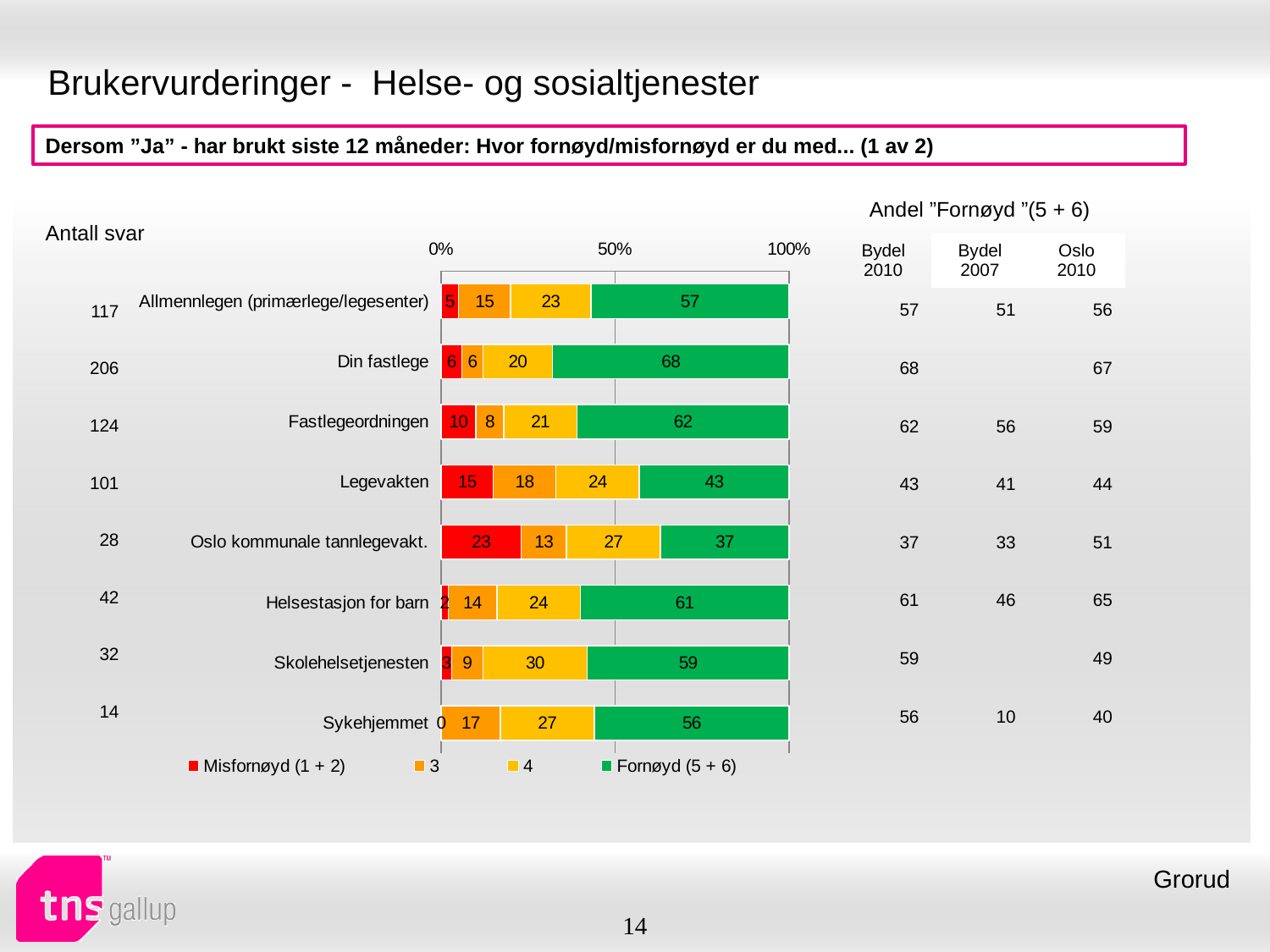
What is the Fornøyd (5 + 6) value for Din fastlege? 68 Which category has the highest Fornøyd (5 + 6) value? Din fastlege How many categories are plotted in the chart? 8 What is the difference between the Fornøyd (5 + 6) values for Fastlegeordningen and Legevakten? 19 What is the total of the stacked bar for Legevakten? 100 What kind of chart is shown on the slide? bar chart What is the value of series 4 for Skolehelsetjenesten? 30 What is the label of the first legend entry in the chart? Misfornøyd (1 + 2) What is the Misfornøyd (1 + 2) value for Legevakten? 15 Which has a larger Misfornøyd (1 + 2) value, Oslo kommunale tannlegevakt. or Fastlegeordningen? Oslo kommunale tannlegevakt. How many series does the chart legend list? 4 Which category has the lowest Fornøyd (5 + 6) value? Oslo kommunale tannlegevakt.